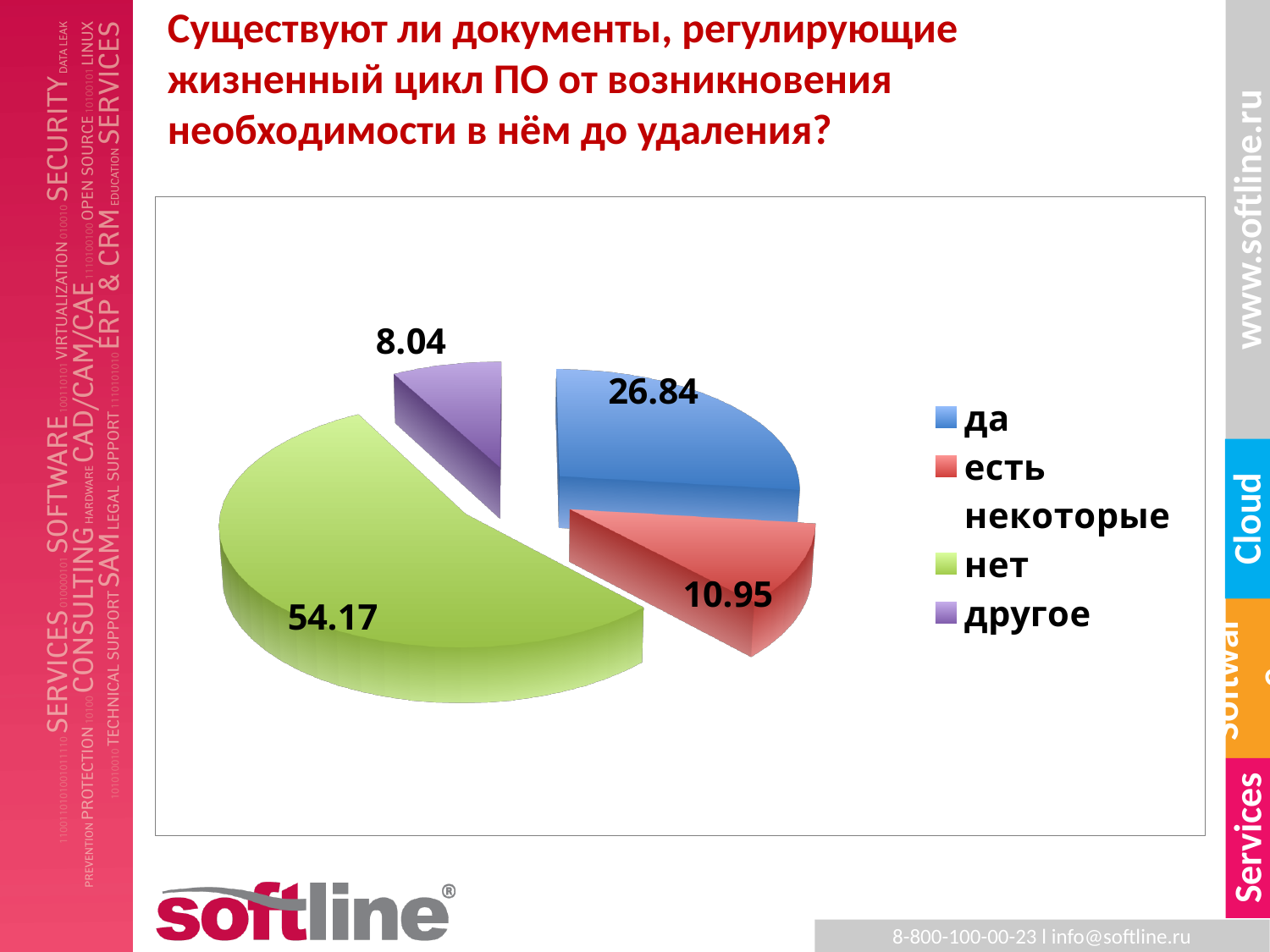
How many entries does the legend list? 4 What colour is the "нет" slice? green What is the value for the "есть некоторые" slice? 10.95 Which category has the smallest slice? другое What is the value for the "нет" slice? 54.17 Which category has the largest slice? нет What kind of chart is shown on the slide? pie chart How many slices does the pie chart have? 4 Which is larger, the value for "да" or the value for "есть некоторые"? да What is the value for the "другое" slice? 8.04 What is the value for the "да" slice? 26.84 What is the difference between the values for "нет" and "да"? 27.33